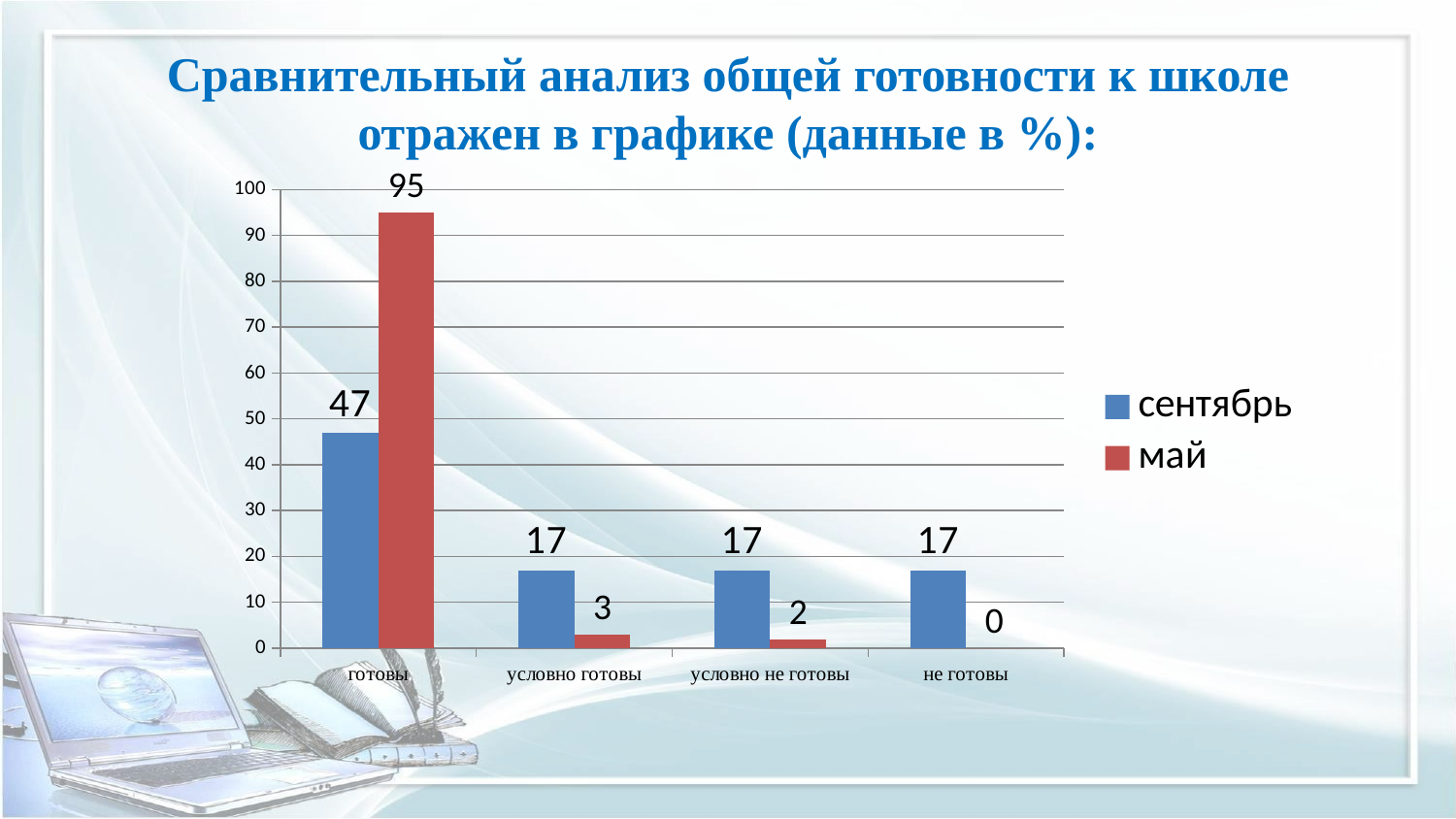
What is the value for "готовы" in the "сентябрь" series? 47 Which category has the lowest value in the "май" series? не готовы What is the value for "не готовы" in the "май" series? 0 What kind of chart is shown on the slide? bar chart Which is larger for "условно не готовы": the "сентябрь" value or the "май" value? сентябрь Is the "май" value for "готовы" greater or less than 90? greater How many series does the legend list? 2 What is the value for "готовы" in the "май" series? 95 How many categories are shown on the x axis? 4 What is the value for "условно готовы" in the "май" series? 3 What is the difference between the "май" and "сентябрь" values for "готовы"? 48 Which category has the highest value in the "май" series? готовы